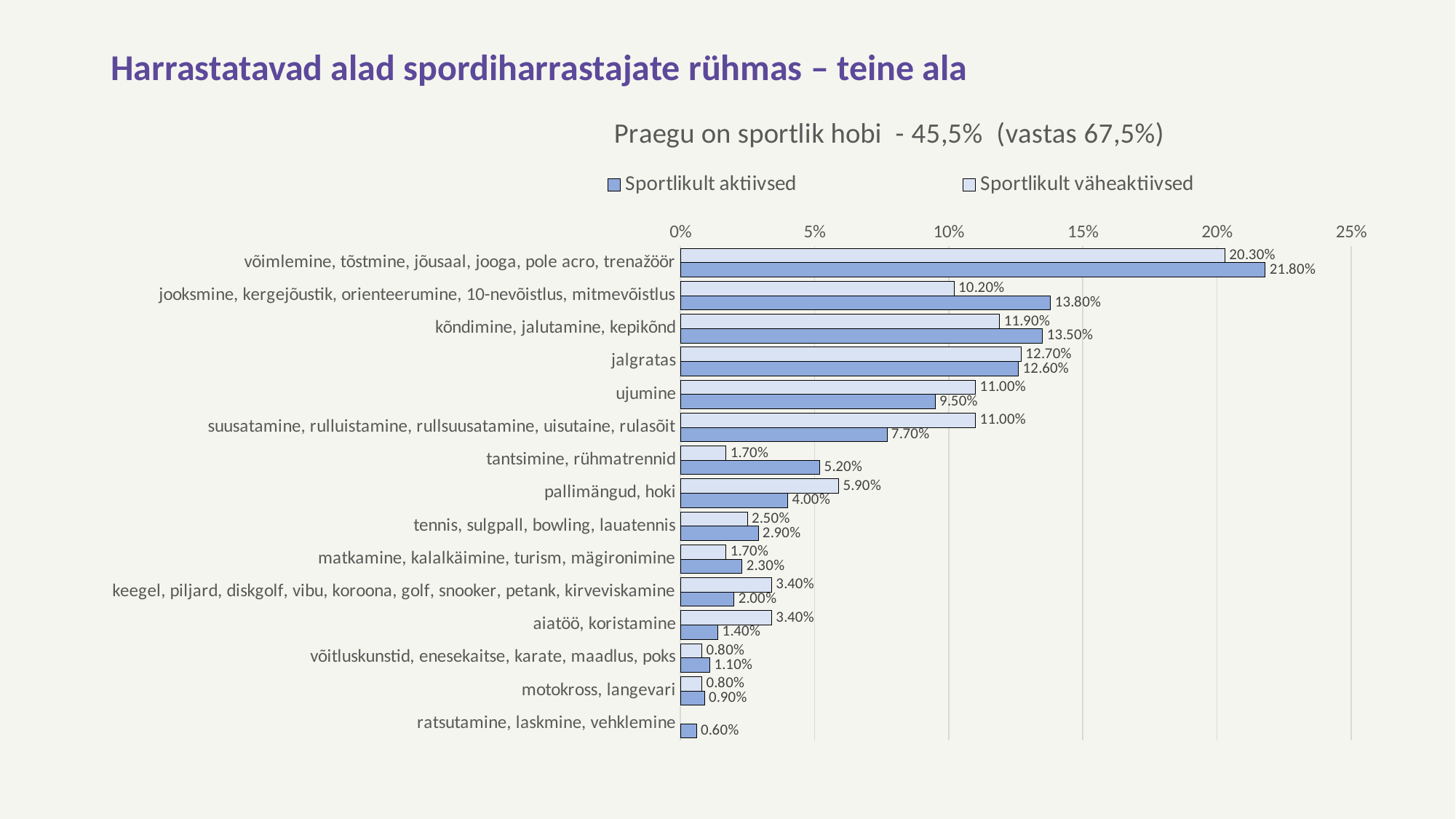
How many series does the legend list? 2 How many categories (activity groups) are shown on the chart? 15 Which category has the highest value for 'Sportlikult aktiivsed'? võimlemine, tõstmine, jõusaal, jooga, pole acro, trenažöör What is the difference between the 'Sportlikult aktiivsed' and 'Sportlikult väheaktiivsed' values for 'jooksmine, kergejõustik, orienteerumine, 10-nevõistlus, mitmevõistlus'? 3.60% What is the title of the chart? Praegu on sportlik hobi - 45,5% (vastas 67,5%) What is the value for 'Sportlikult väheaktiivsed' in the category 'ujumine'? 11.00% For 'pallimängud, hoki', which series has the larger value: 'Sportlikult aktiivsed' or 'Sportlikult väheaktiivsed'? Sportlikult väheaktiivsed What is the value for 'Sportlikult aktiivsed' in the category 'tantsimine, rühmatrennid'? 5.20% What kind of chart is shown on the slide? bar chart Is the 'Sportlikult aktiivsed' value for 'võimlemine, tõstmine, jõusaal, jooga, pole acro, trenažöör' greater or less than 20%? greater Which category has the lowest value for 'Sportlikult aktiivsed'? ratsutamine, laskmine, vehklemine What is the value for 'Sportlikult aktiivsed' in the category 'jalgratas'? 12.60%